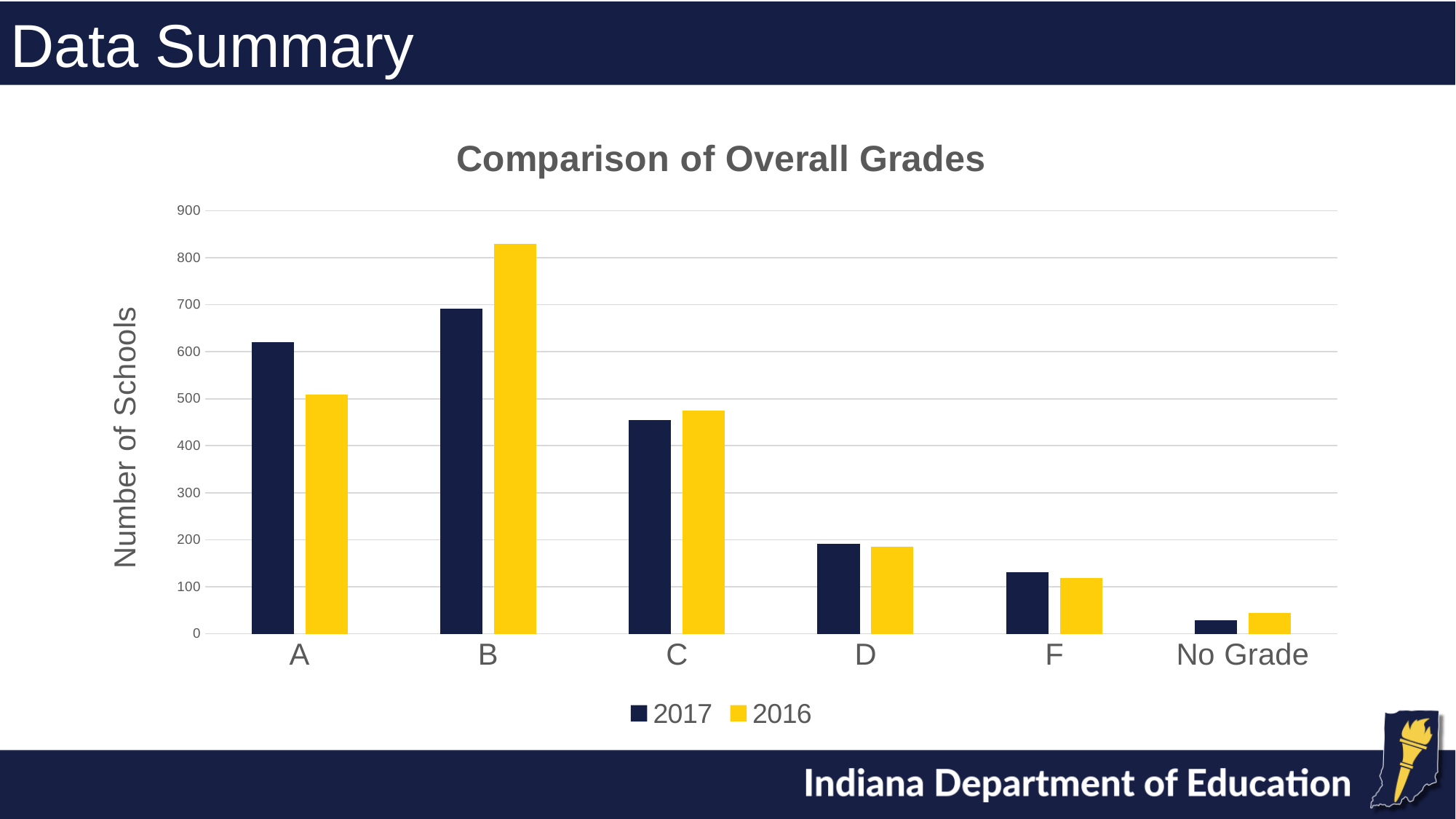
What is the label of the y axis? Number of Schools What type of chart is shown on the slide? Bar chart For grade B, which year has more schools, 2017 or 2016? 2016 Which grade category has the highest number of schools for 2016? B For grade A, which year has more schools, 2017 or 2016? 2017 Is the number of schools with grade C in 2017 greater or less than 500? less Is the number of schools with grade B in 2016 greater or less than 800? greater Which grade category has the lowest number of schools for 2017? No Grade How many series does the legend list? 2 Which grade category has the highest number of schools for 2017? B What is the title of the chart? Comparison of Overall Grades How many grade categories are shown on the x axis? 6